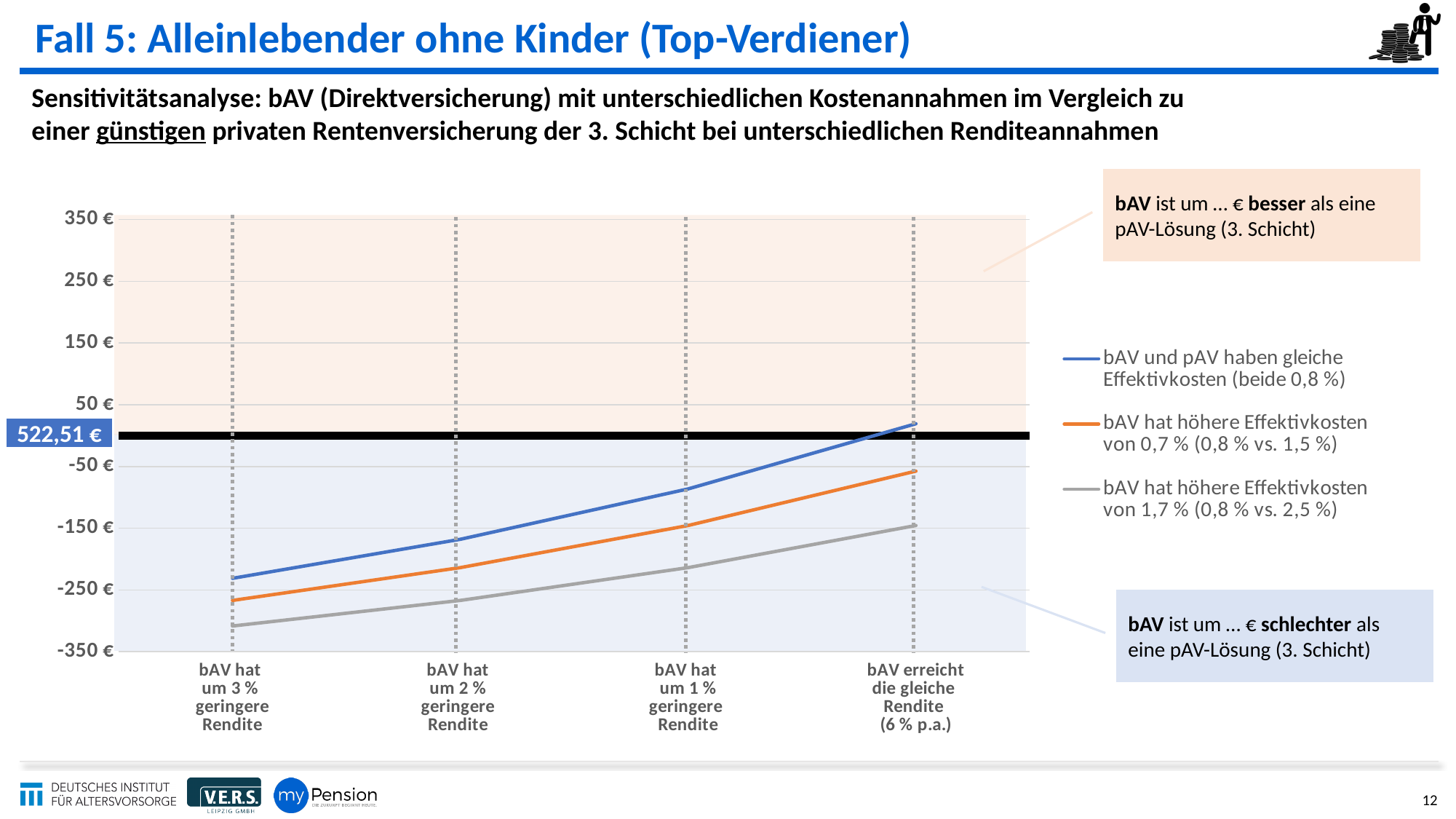
How many categories are shown along the x axis? 4 At 'bAV hat um 1 % geringere Rendite', which series has the higher value: 'bAV und pAV haben gleiche Effektivkosten (beide 0,8 %)' or 'bAV hat höhere Effektivkosten von 1,7 % (0,8 % vs. 2,5 %)'? bAV und pAV haben gleiche Effektivkosten (beide 0,8 %) Is the value of the series 'bAV hat höhere Effektivkosten von 1,7 % (0,8 % vs. 2,5 %)' at 'bAV hat um 3 % geringere Rendite' greater or less than -250 €? less For which category is the series 'bAV hat höhere Effektivkosten von 1,7 % (0,8 % vs. 2,5 %)' lowest? bAV hat um 3 % geringere Rendite Do the values of the series 'bAV und pAV haben gleiche Effektivkosten (beide 0,8 %)' rise or fall from left to right along the x axis? rise How many series does the legend list? 3 For which category is the series 'bAV und pAV haben gleiche Effektivkosten (beide 0,8 %)' highest? bAV erreicht die gleiche Rendite (6 % p.a.) What value is labelled on the black horizontal reference line in the chart? 522,51 € What kind of chart is shown on the slide? line chart Is the value of the series 'bAV und pAV haben gleiche Effektivkosten (beide 0,8 %)' at 'bAV hat um 3 % geringere Rendite' greater or less than -250 €? greater What colour is the line for the series 'bAV hat höhere Effektivkosten von 0,7 % (0,8 % vs. 1,5 %)'? orange Is the value of the series 'bAV und pAV haben gleiche Effektivkosten (beide 0,8 %)' at 'bAV erreicht die gleiche Rendite (6 % p.a.)' greater or less than 50 €? less